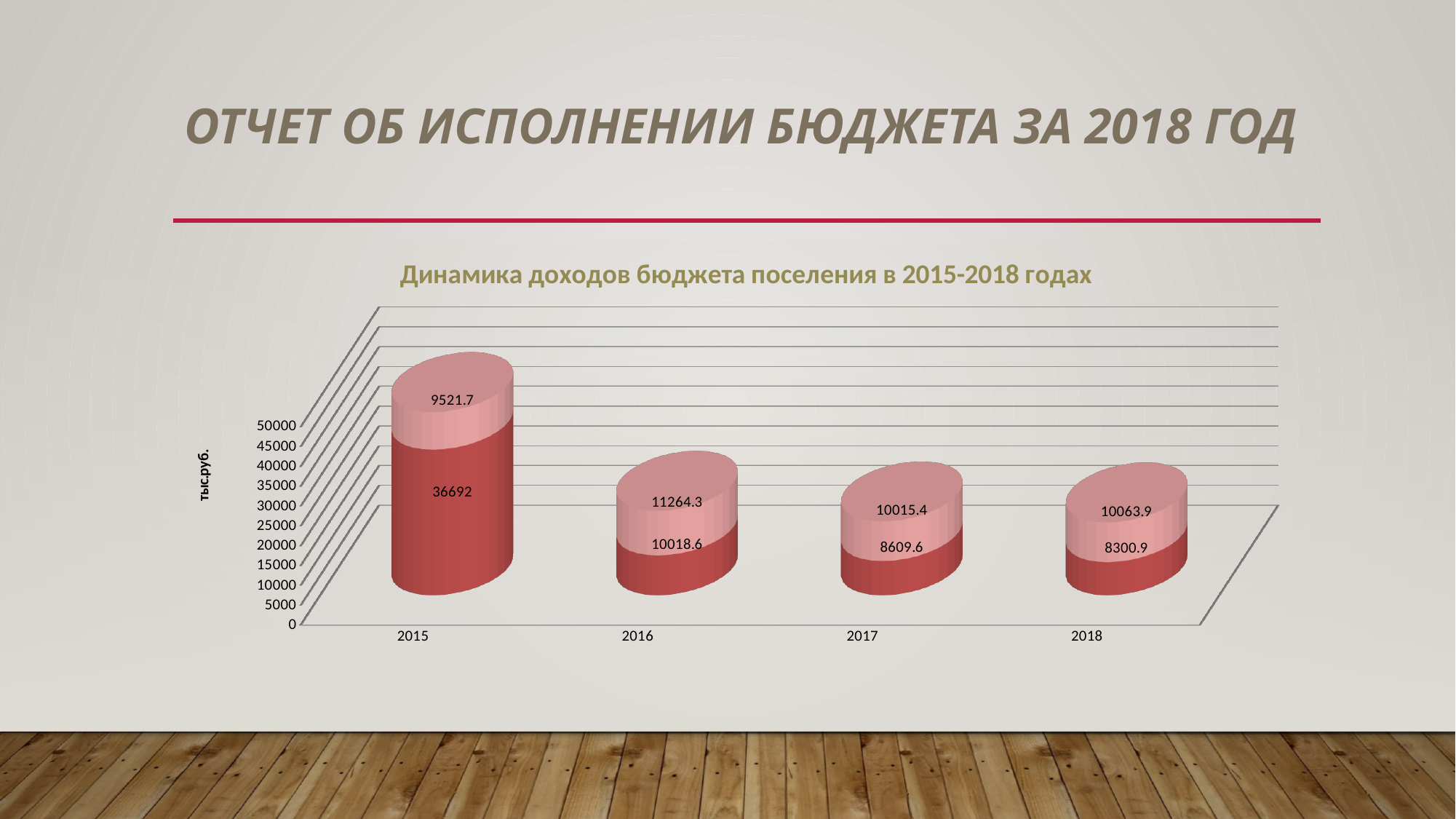
What is the label on the vertical axis of the chart? тыс.руб. Which year has the smallest value for the lower (darker red) segment? 2018 What is the value of the upper (lighter pink) segment for 2016? 11264.3 How many years (categories) are shown on the x axis? 4 What is the value of the upper (lighter pink) segment for 2017? 10015.4 What is the value of the lower (darker red) segment for 2015? 36692 What is the total of the stacked bar for 2015? 46213.7 What is the difference between the lower (darker red) segment values for 2015 and 2016? 26673.4 What is the value of the lower (darker red) segment for 2018? 8300.9 What is the total of the stacked bar for 2016? 21282.9 Which year has the tallest stacked bar overall? 2015 What kind of chart is shown on the slide? Stacked bar chart